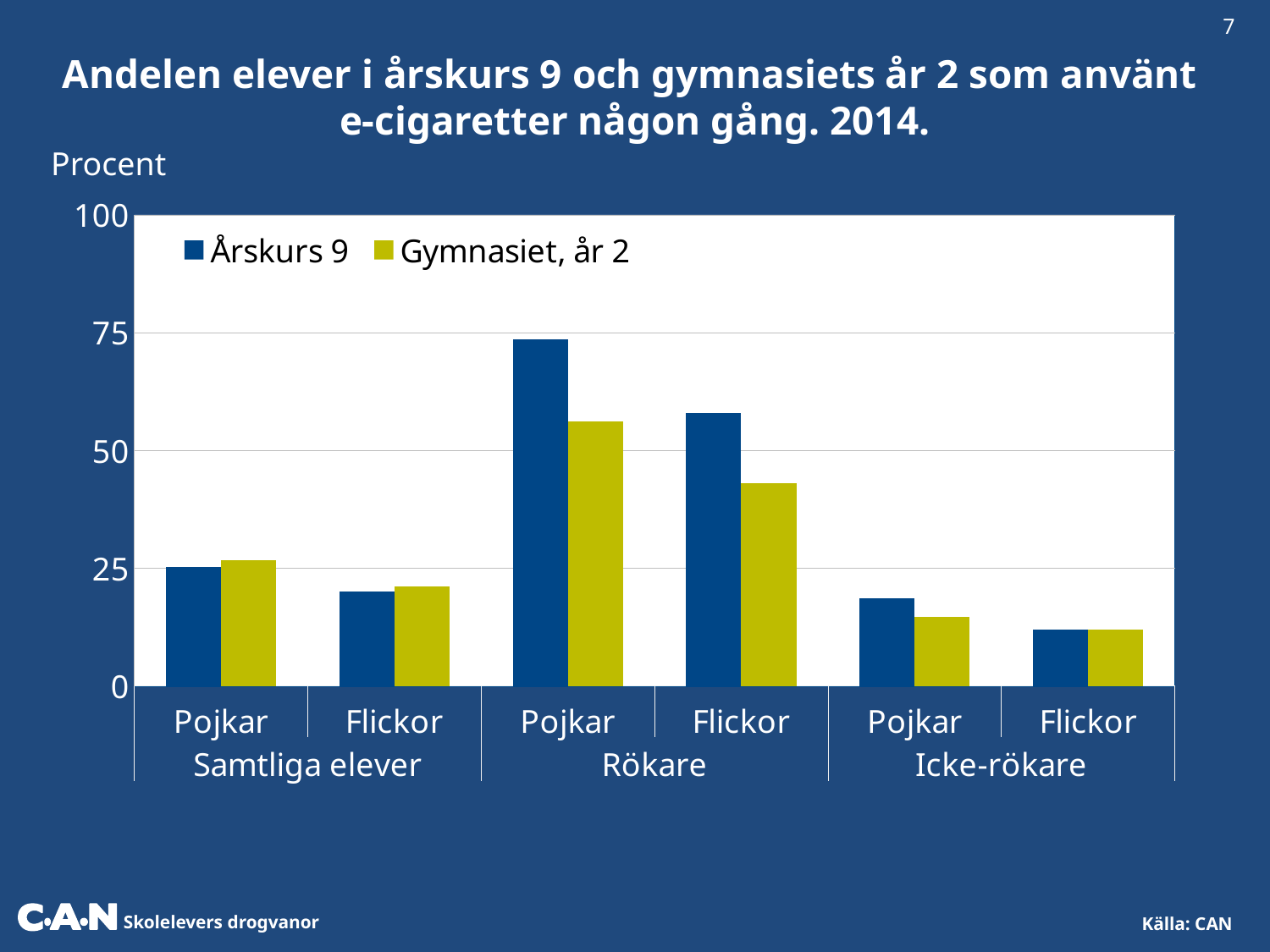
How many main groups are shown along the x axis? 3 For Flickor among Rökare, which series has the larger value, Årskurs 9 or Gymnasiet, år 2? Årskurs 9 How many bars are plotted for the Årskurs 9 series? 6 For Pojkar among Icke-rökare, which series has the larger value, Årskurs 9 or Gymnasiet, år 2? Årskurs 9 Is the Årskurs 9 value for Pojkar among Icke-rökare greater or less than 25? less What kind of chart is shown on the slide? bar chart How many series does the legend list? 2 What are the two series named in the legend? Årskurs 9 and Gymnasiet, år 2 What label is shown on the vertical axis of the chart? Procent Which category has the highest value in the chart? Pojkar, Rökare (Årskurs 9) Is the Årskurs 9 value for Pojkar among Rökare greater or less than 50? greater Is the Gymnasiet, år 2 value for Flickor among Rökare greater or less than 50? less